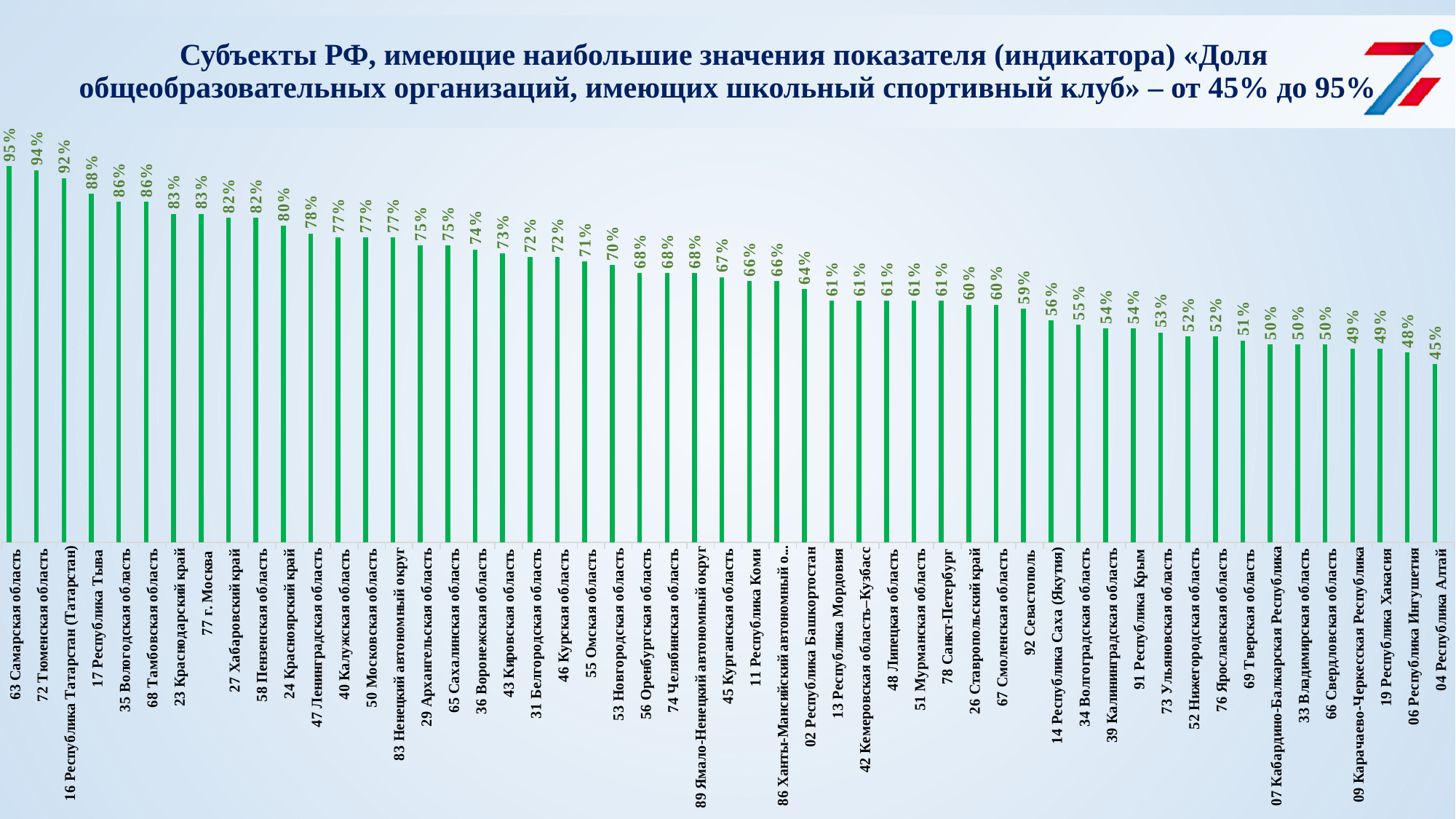
Which is larger, the value for 17 Республика Тыва or the value for 24 Красноярский край? 17 Республика Тыва Which region has the highest value on the chart? 63 Самарская область What colour are the bars on the chart? Green What is the value for 63 Самарская область? 95% How many regions are shown on the chart? 53 What is the value for 77 г. Москва? 83% Do the values rise or fall from left to right along the x axis? Fall What is the difference between the values for 72 Тюменская область and 06 Республика Ингушетия? 46% What kind of chart is shown on the slide? Bar chart Which region has the lowest value on the chart? 04 Республика Алтай What is the value for 92 Севастополь? 59% What is the value for 78 Санкт-Петербург? 61%